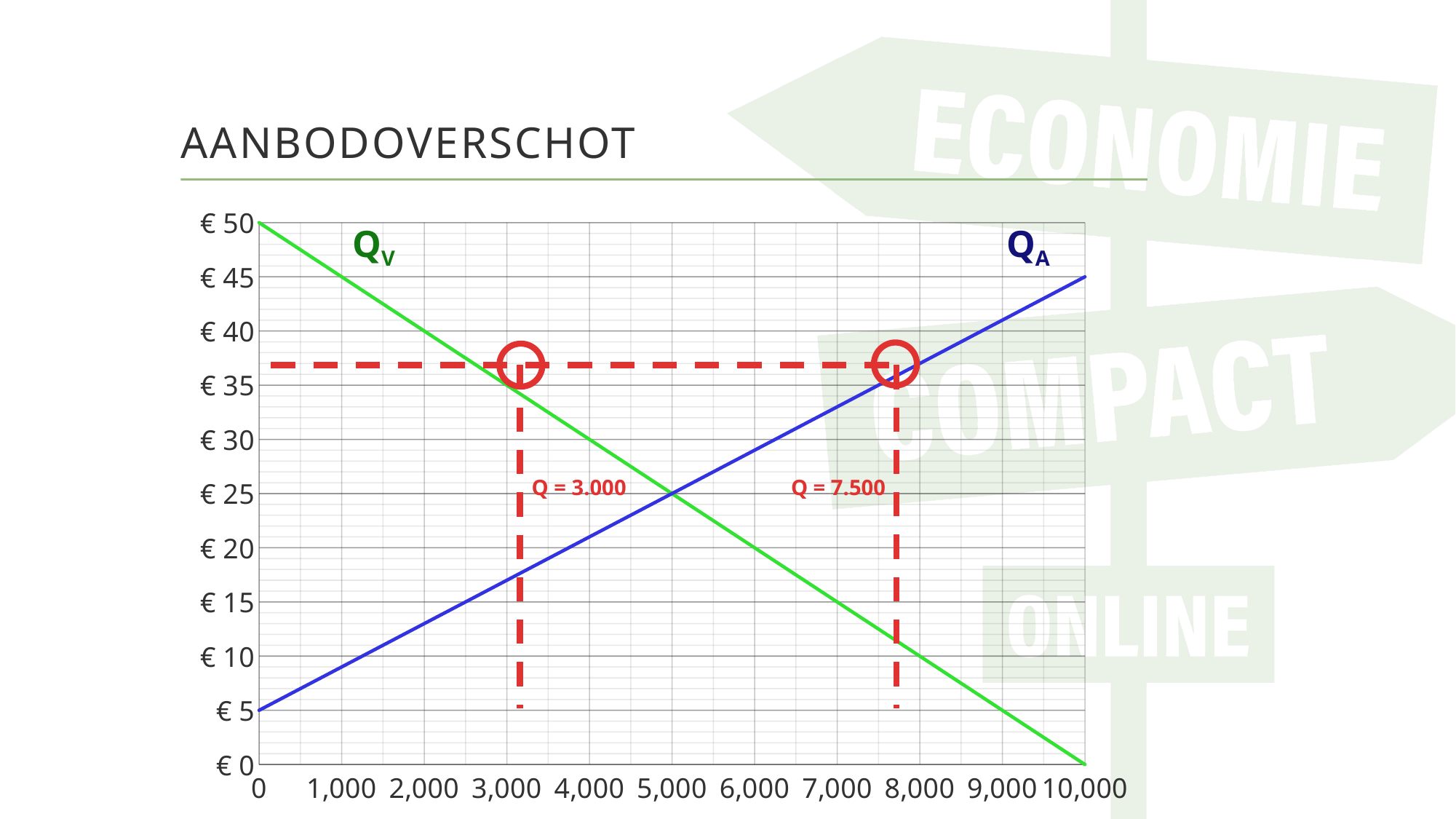
Does the Q_V line rise or fall as quantity increases along the x axis? falls Does the Q_A line rise or fall as quantity increases along the x axis? rises How many lines (series) are plotted on the chart? 2 What quantity is labelled at the left red circle on the dashed line? Q = 3.000 What is the title of the slide? AANBODOVERSCHOT Is the price of the horizontal red dashed line greater or less than € 35? greater What price does the Q_A line start at when the quantity is 0? € 5 What price does the Q_V line start at when the quantity is 0? € 50 What is the difference between the two quantities labelled on the dashed lines (7.500 and 3.000)? 4.500 What kind of chart is shown on the slide? line chart At a quantity of 2,000, which line shows the higher price, Q_V or Q_A? Q_V What price does the Q_A line reach at a quantity of 10,000? € 45